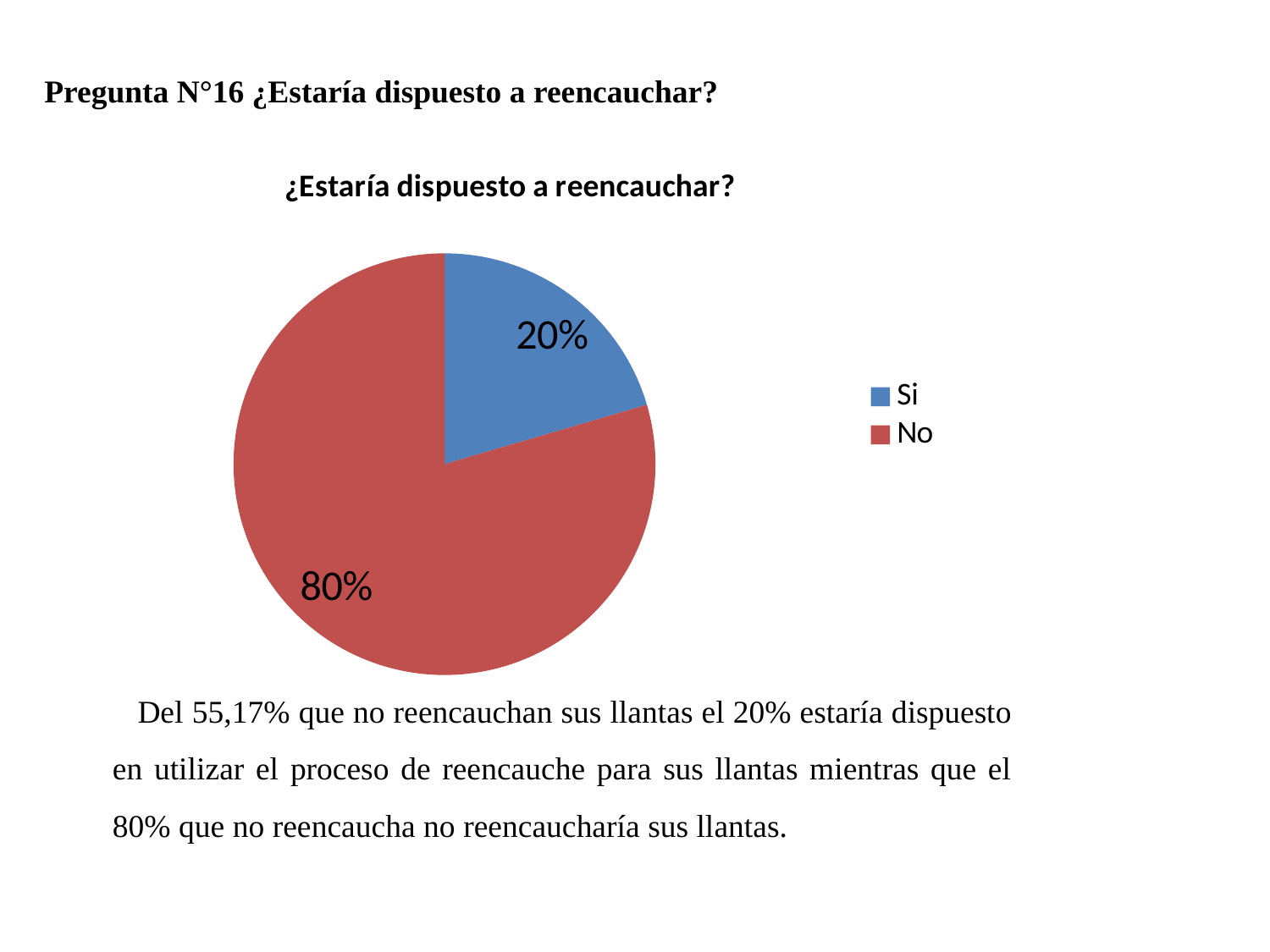
How many categories does the pie chart have? 2 What share of the pie does the "No" slice represent? 80% What kind of chart is shown on the slide? pie chart What is the difference in percentage points between the "No" and "Si" slices? 60 What share of the pie does the "Si" slice represent? 20% Which category has the smallest slice of the pie? Si Which slice is larger, "Si" or "No"? No Which category has the largest slice of the pie? No What colour is the "No" slice? red What is the title of the chart? ¿Estaría dispuesto a reencauchar? How many entries does the legend list? 2